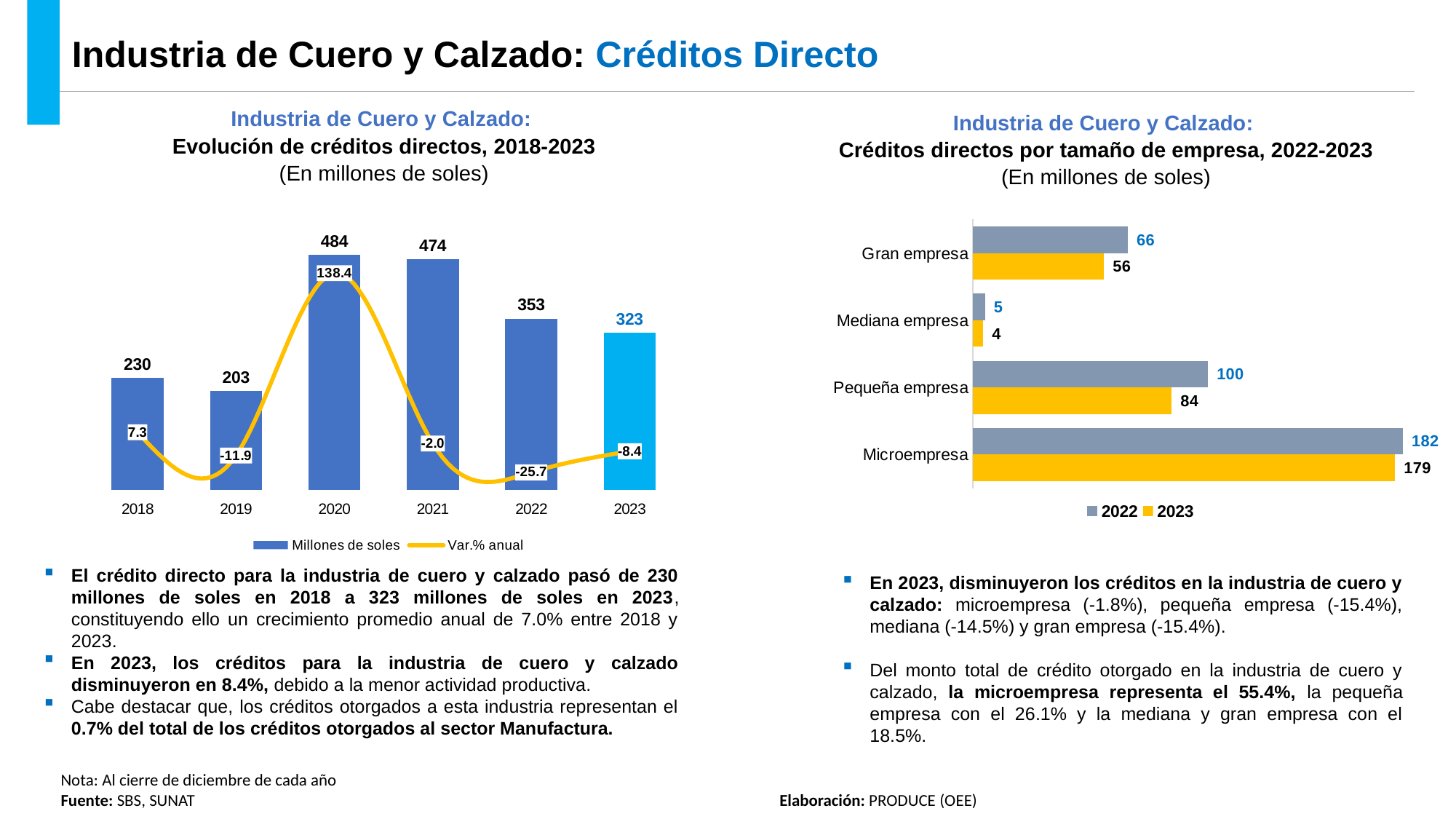
In the left chart (Evolución de créditos directos, 2018-2023), how many series does the legend list? 2 In the left chart (Evolución de créditos directos, 2018-2023), what is the Var.% anual value for 2022? -25.7 In the right chart (Créditos directos por tamaño de empresa, 2022-2023), which is larger: Mediana empresa in 2022 or Mediana empresa in 2023? Mediana empresa in 2022 In the left chart (Evolución de créditos directos, 2018-2023), what is the value of Millones de soles for 2020? 484 In the left chart (Evolución de créditos directos, 2018-2023), which year has the lowest value of Millones de soles? 2019 In the left chart (Evolución de créditos directos, 2018-2023), what is the difference in Millones de soles between 2021 and 2022? 121 What kind of chart is the right chart (Créditos directos por tamaño de empresa, 2022-2023)? Bar chart In the right chart (Créditos directos por tamaño de empresa, 2022-2023), what is the value for Pequeña empresa in 2023? 84 In the right chart (Créditos directos por tamaño de empresa, 2022-2023), what is the difference between the 2022 and 2023 values for Gran empresa? 10 In the left chart (Evolución de créditos directos, 2018-2023), which year has the highest value of Millones de soles? 2020 In the left chart (Evolución de créditos directos, 2018-2023), how many years are shown on the x axis? 6 In the right chart (Créditos directos por tamaño de empresa, 2022-2023), which company size has the highest value in 2022? Microempresa